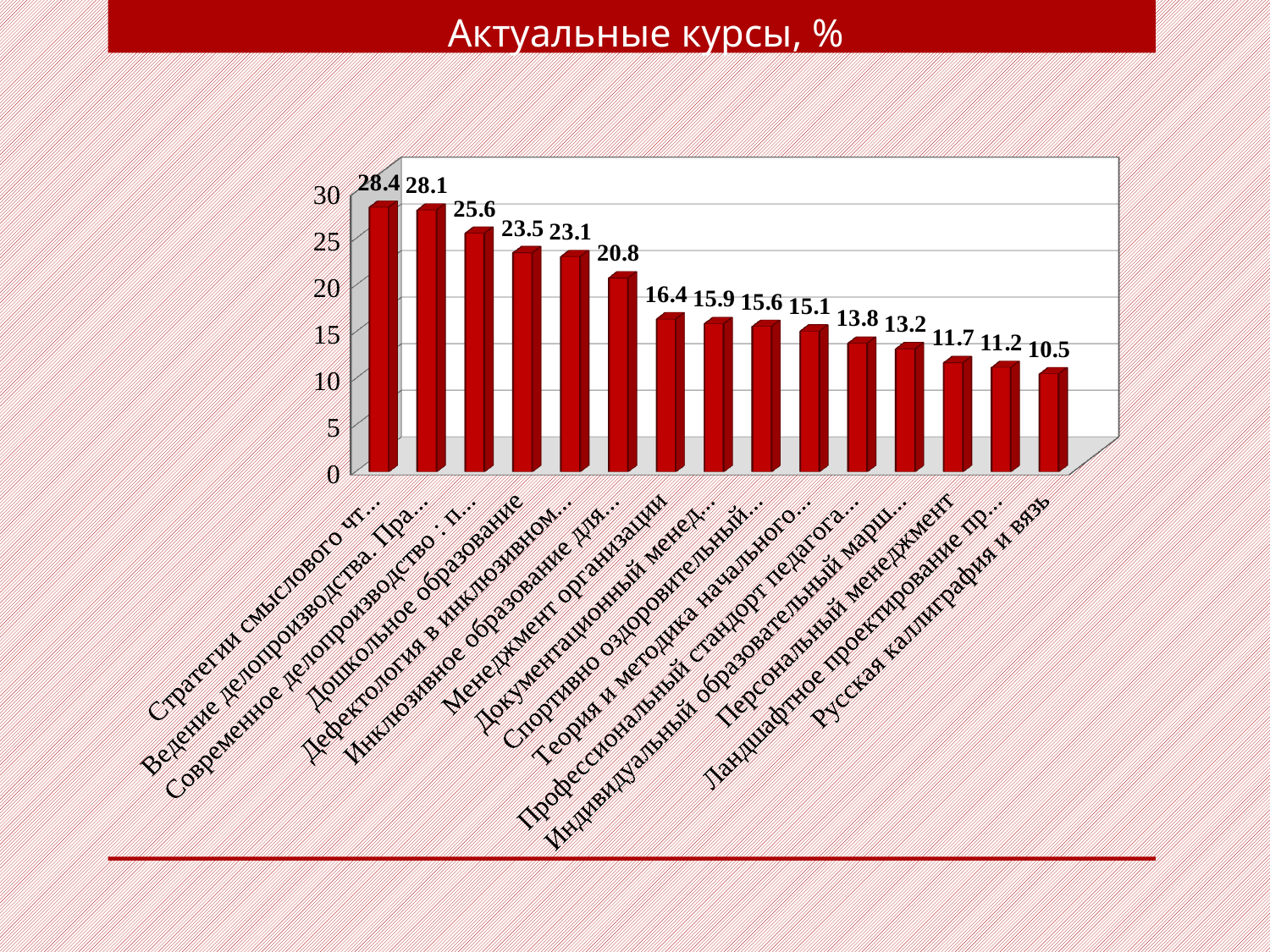
What is the value for Персональный менеджмент? 11.7 What is the value for Русская каллиграфия и вязь? 10.5 How many bars (categories) are plotted in the chart? 15 What is the difference between the values for Дошкольное образование and Менеджмент организации? 7.1 What is the title of the chart? Актуальные курсы, % Which category has the lowest value in the chart? Русская каллиграфия и вязь What is the value for Дошкольное образование? 23.5 Do the values rise or fall from left to right along the x axis? fall What is the highest value shown in the chart? 28.4 Which is larger, the value for Персональный менеджмент or the value for Русская каллиграфия и вязь? Персональный менеджмент What is the value for Менеджмент организации? 16.4 What type of chart is shown on the slide? bar chart